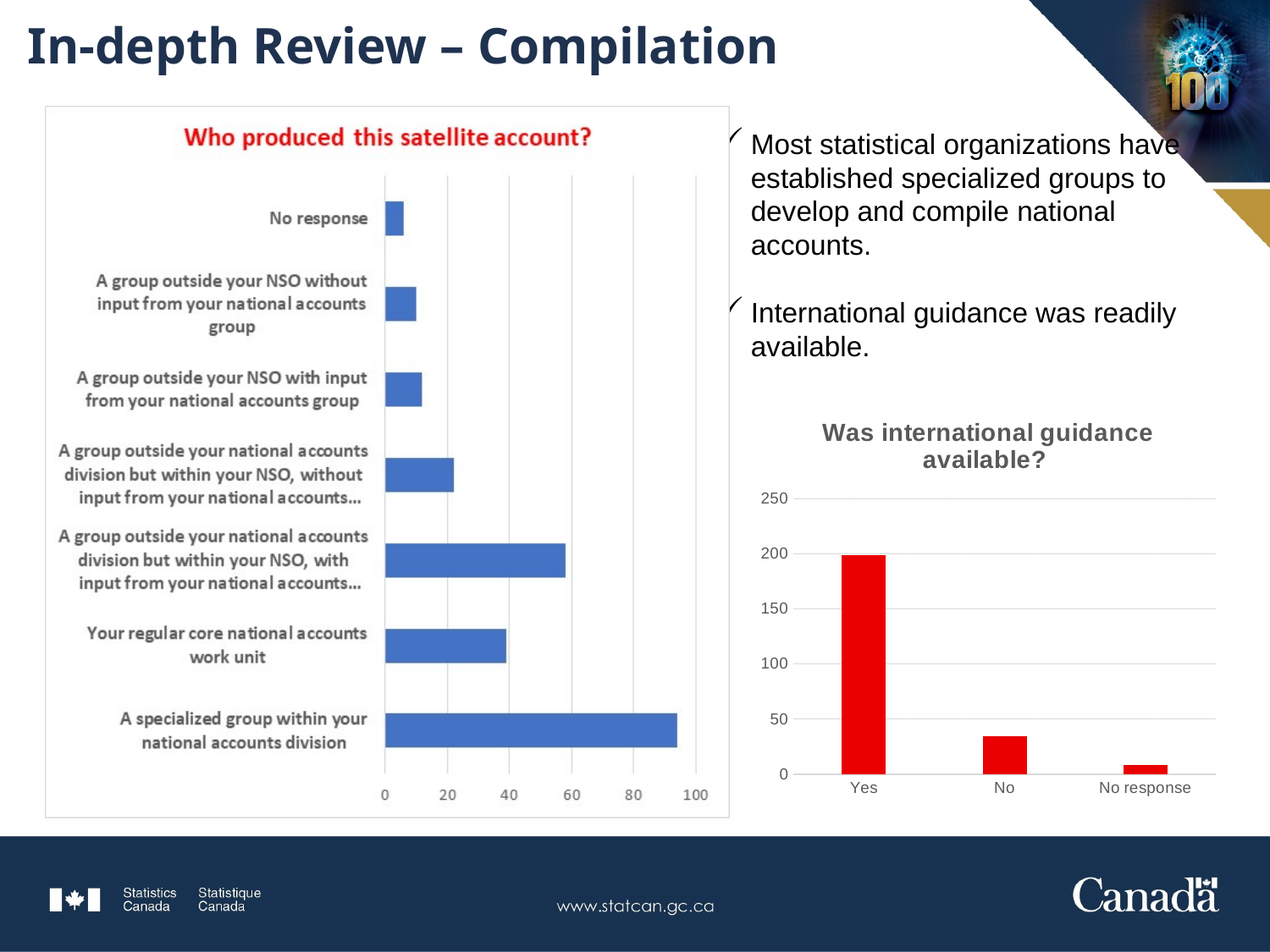
In the chart titled "Who produced this satellite account?", what kind of chart is shown? bar chart In the chart titled "Who produced this satellite account?", how many categories are plotted? 7 In the chart titled "Who produced this satellite account?", which category has the lowest value? No response In the chart titled "Who produced this satellite account?", is the value for "A specialized group within your national accounts division" greater or less than 80? greater In the chart titled "Was international guidance available?", how many categories are plotted? 3 In the chart titled "Who produced this satellite account?", which category has the highest value? A specialized group within your national accounts division In the chart titled "Was international guidance available?", is the value for "No" greater or less than 50? less In the chart titled "Who produced this satellite account?", is the value for "Your regular core national accounts work unit" greater or less than 20? greater In the chart titled "Was international guidance available?", which category has the highest value? Yes In the chart titled "Was international guidance available?", what kind of chart is shown? bar chart In the chart titled "Who produced this satellite account?", which is larger: the value for "Your regular core national accounts work unit" or the value for "A group outside your NSO with input from your national accounts group"? Your regular core national accounts work unit